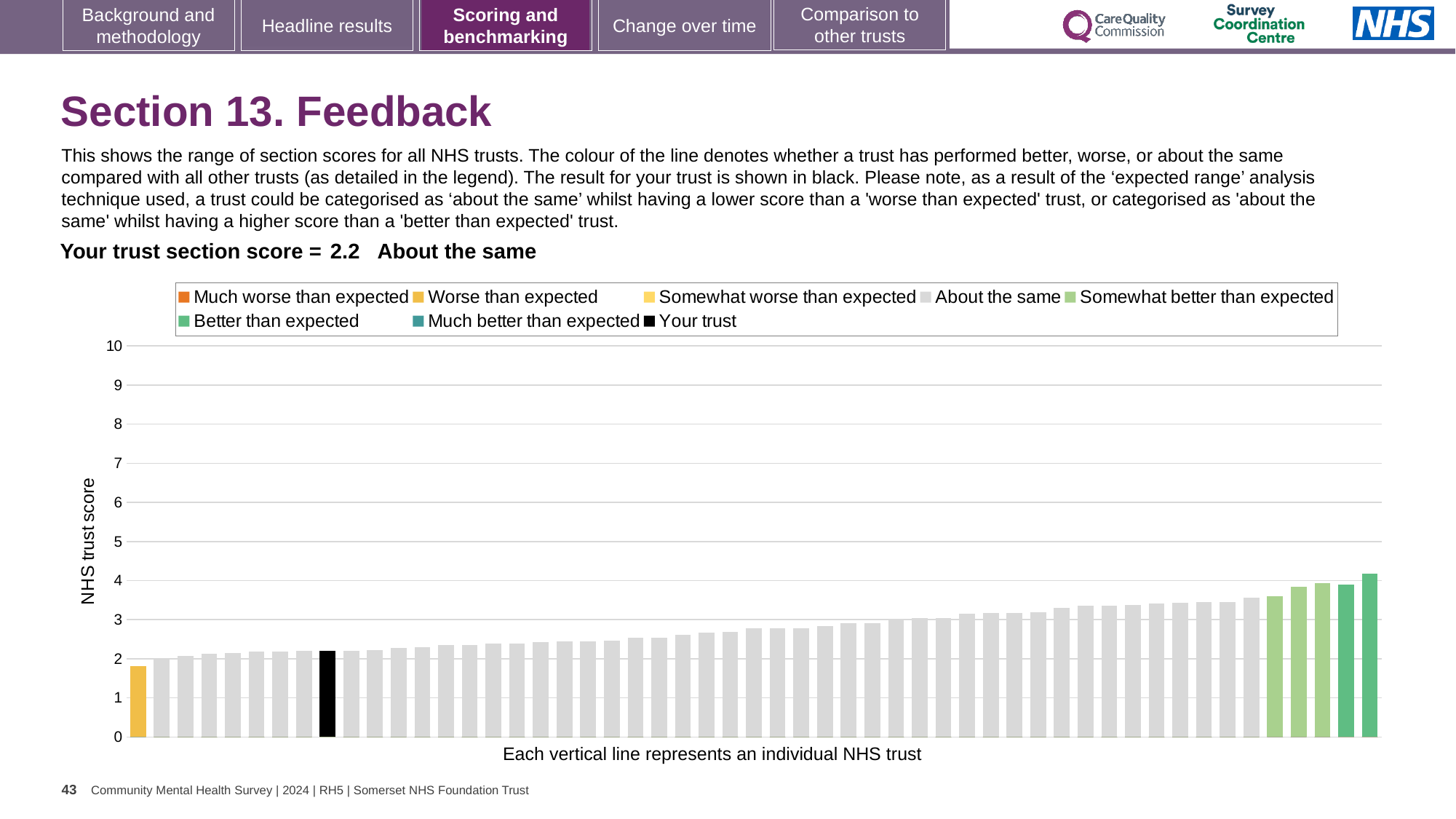
How many yellow bars are there in the chart? 1 Is the value for your trust greater or less than 2? greater Which is taller, the leftmost bar or the rightmost bar? the rightmost bar What is the section score for your trust? 2.2 Is the value of the leftmost bar greater or less than 2? less How many entries does the chart legend list? 8 Is the value of the tallest bar greater or less than 4? greater How is your trust's section score categorised compared with other trusts? About the same What kind of chart is shown on the slide? bar chart What is the title of the vertical axis? NHS trust score Do the bar values rise or fall from left to right along the x axis? rise